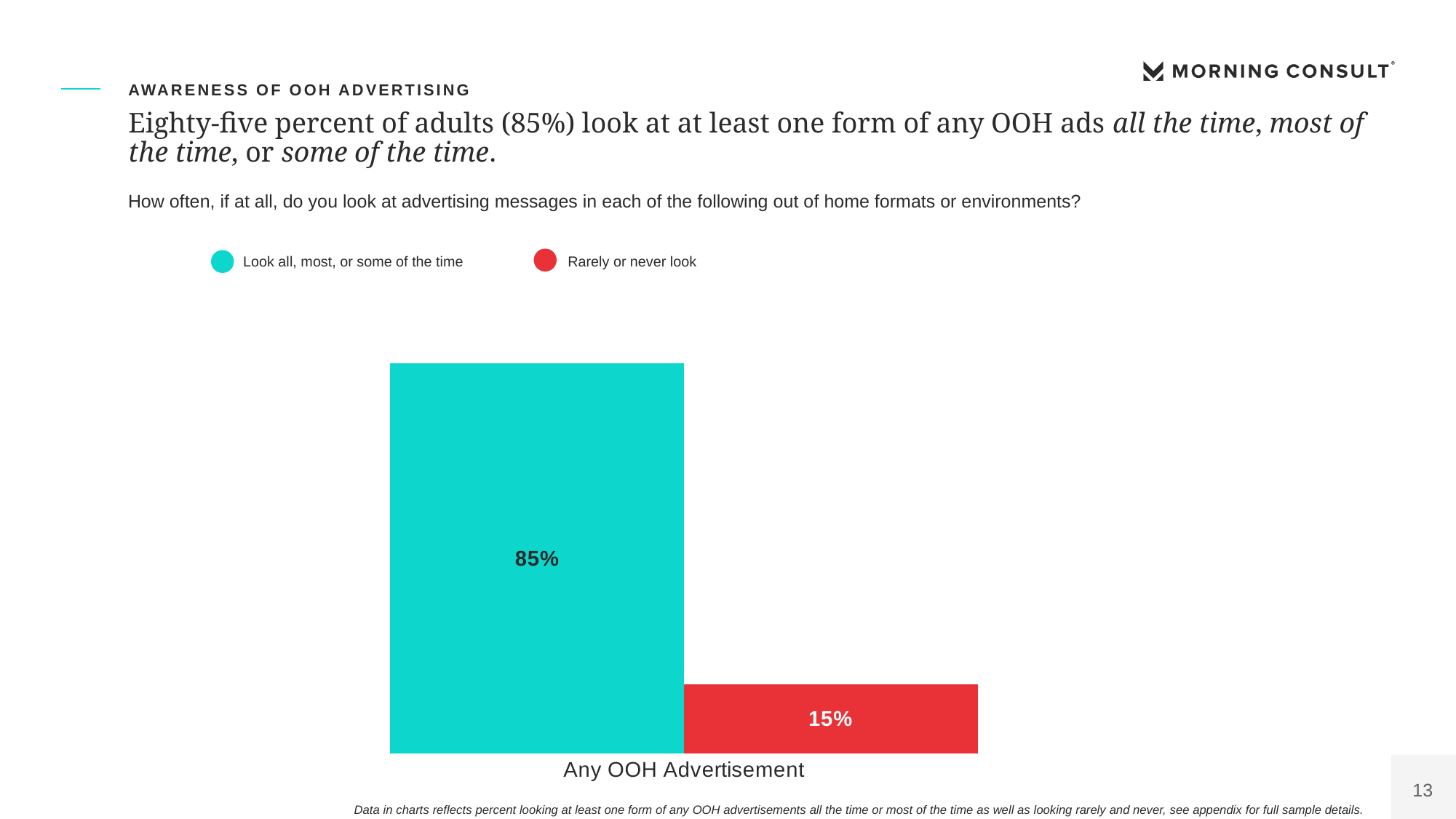
How many series does the legend list? 2 How many categories are shown on the x axis? 1 What kind of chart is shown on the slide? bar chart What colour is the bar for 'Rarely or never look'? red What is the difference in percentage points between those who look all, most, or some of the time and those who rarely or never look? 70 Which series has the higher value for Any OOH Advertisement? Look all, most, or some of the time What is the total of the two values shown for Any OOH Advertisement? 100% Which series has the lower value for Any OOH Advertisement? Rarely or never look What percentage of adults rarely or never look at any OOH advertisement? 15% What is the category label shown beneath the bars? Any OOH Advertisement Is the value for 'Look all, most, or some of the time' larger or smaller than the value for 'Rarely or never look'? larger What percentage of adults look at any OOH advertisement all, most, or some of the time? 85%